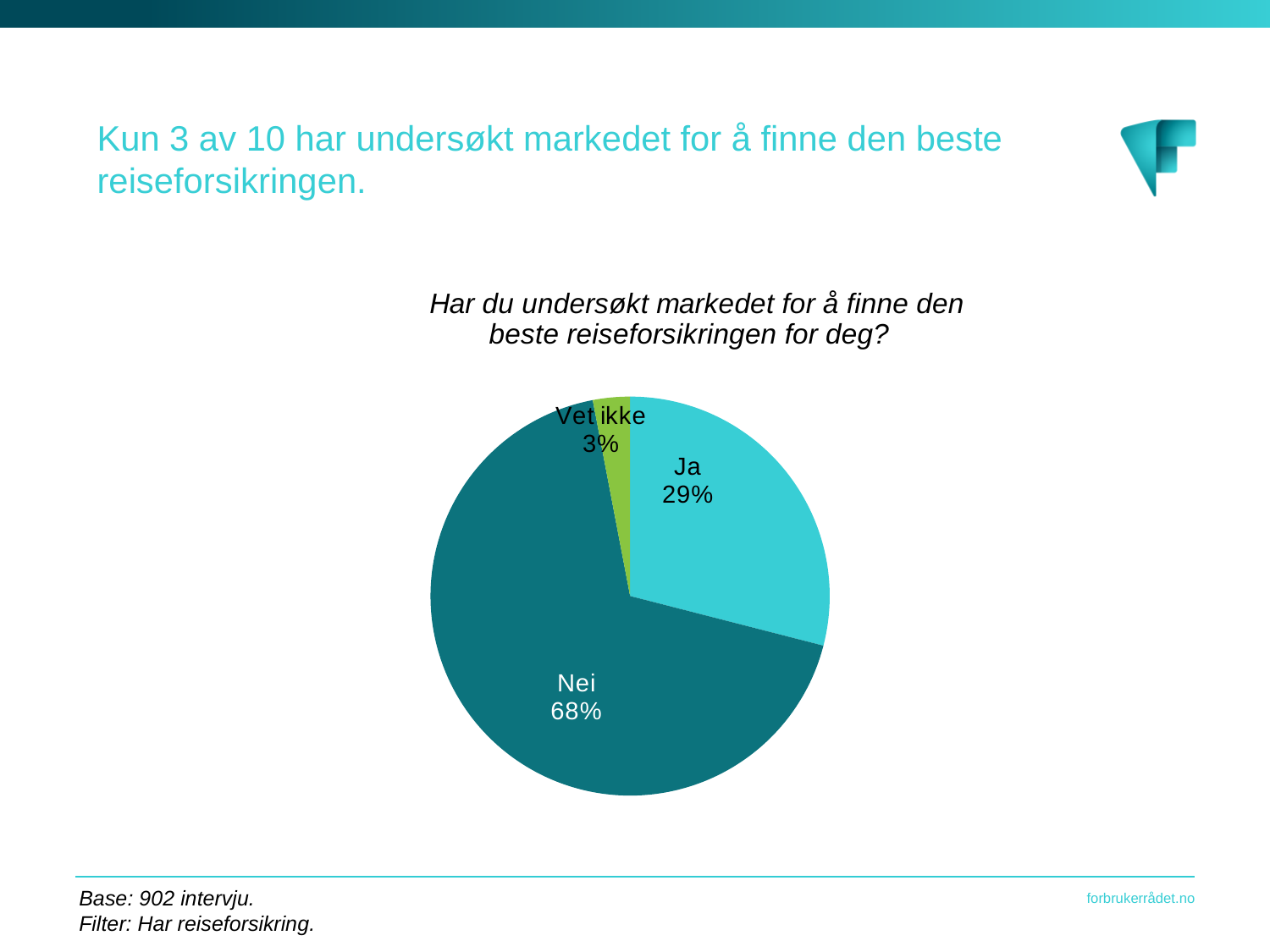
What share of the pie does the "Nei" slice represent? 68% What colour is the "Vet ikke" slice? Green What kind of chart is shown on the slide? Pie chart What percentage of respondents answered "Vet ikke"? 3% Which response has the smallest share of the pie? Vet ikke What question is the pie chart based on, as shown in its title? Har du undersøkt markedet for å finne den beste reiseforsikringen for deg? What percentage of respondents answered "Ja"? 29% What is the difference in percentage points between "Nei" and "Ja"? 39 How many slices does the pie chart have? 3 Which response has the largest share of the pie? Nei Which is larger, the share for "Ja" or the share for "Vet ikke"? Ja What percentage of respondents answered "Nei"? 68%